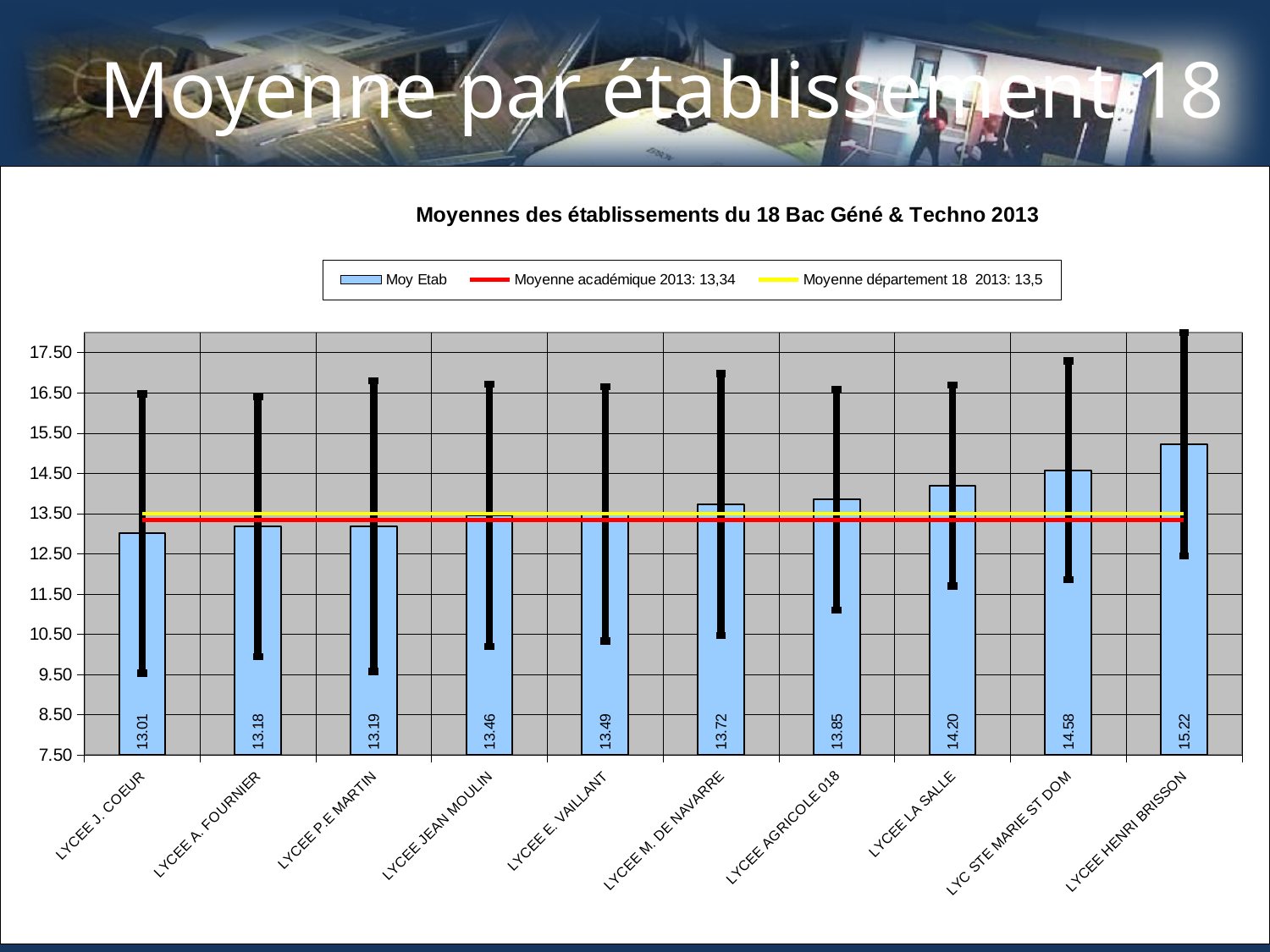
What is the title of the chart? Moyennes des établissements du 18 Bac Géné & Techno 2013 What kind of chart is this? bar chart Which establishment has the lowest average? LYCEE J. COEUR Which is larger, the value for LYCEE LA SALLE or the value for LYCEE AGRICOLE 018? LYCEE LA SALLE What is the value for LYCEE J. COEUR? 13.01 How many establishments are shown on the x axis? 10 Is the value for LYC STE MARIE ST DOM greater or less than 14.50? greater What is the value for LYCEE HENRI BRISSON? 15.22 What is the difference between the values for LYCEE HENRI BRISSON and LYCEE J. COEUR? 2.21 Which establishment has the highest average? LYCEE HENRI BRISSON What is the value for LYCEE M. DE NAVARRE? 13.72 How many entries does the legend list? 3